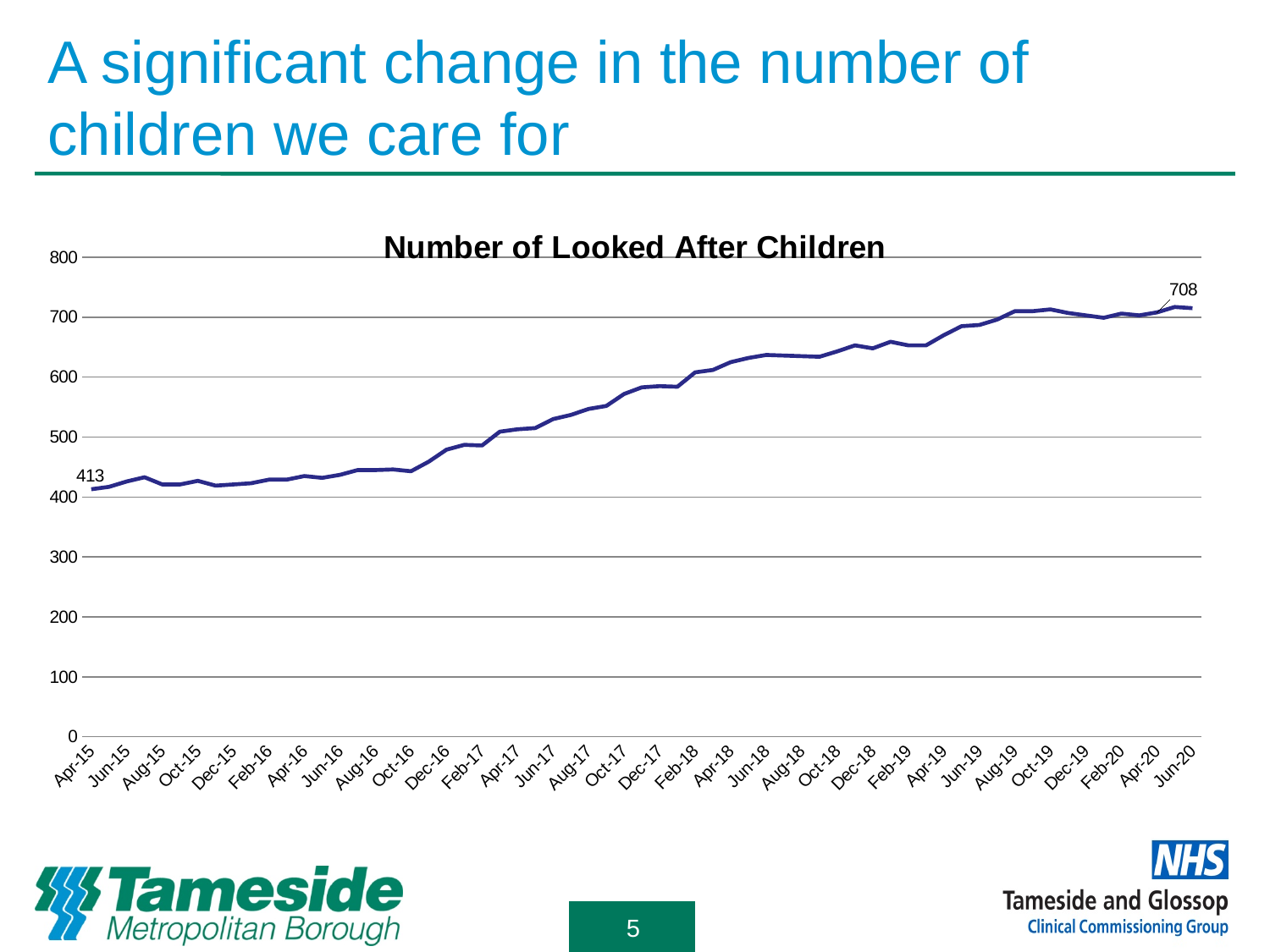
What is the title of the chart on the slide? Number of Looked After Children Is the value for Apr-19 in the Number of Looked After Children chart greater or less than 600? greater What kind of chart is the Number of Looked After Children chart? line chart Do the values in the Number of Looked After Children chart generally rise or fall from Apr-15 to Jun-20? rise What is the highest value shown on the y axis of the Number of Looked After Children chart? 800 Is the value for Jun-18 in the Number of Looked After Children chart greater or less than 600? greater Which is larger in the Number of Looked After Children chart, the value for Apr-15 or the value for Jun-20? Jun-20 Is the value for Jun-15 in the Number of Looked After Children chart greater or less than 500? less What is the value for Apr-15 in the Number of Looked After Children chart? 413